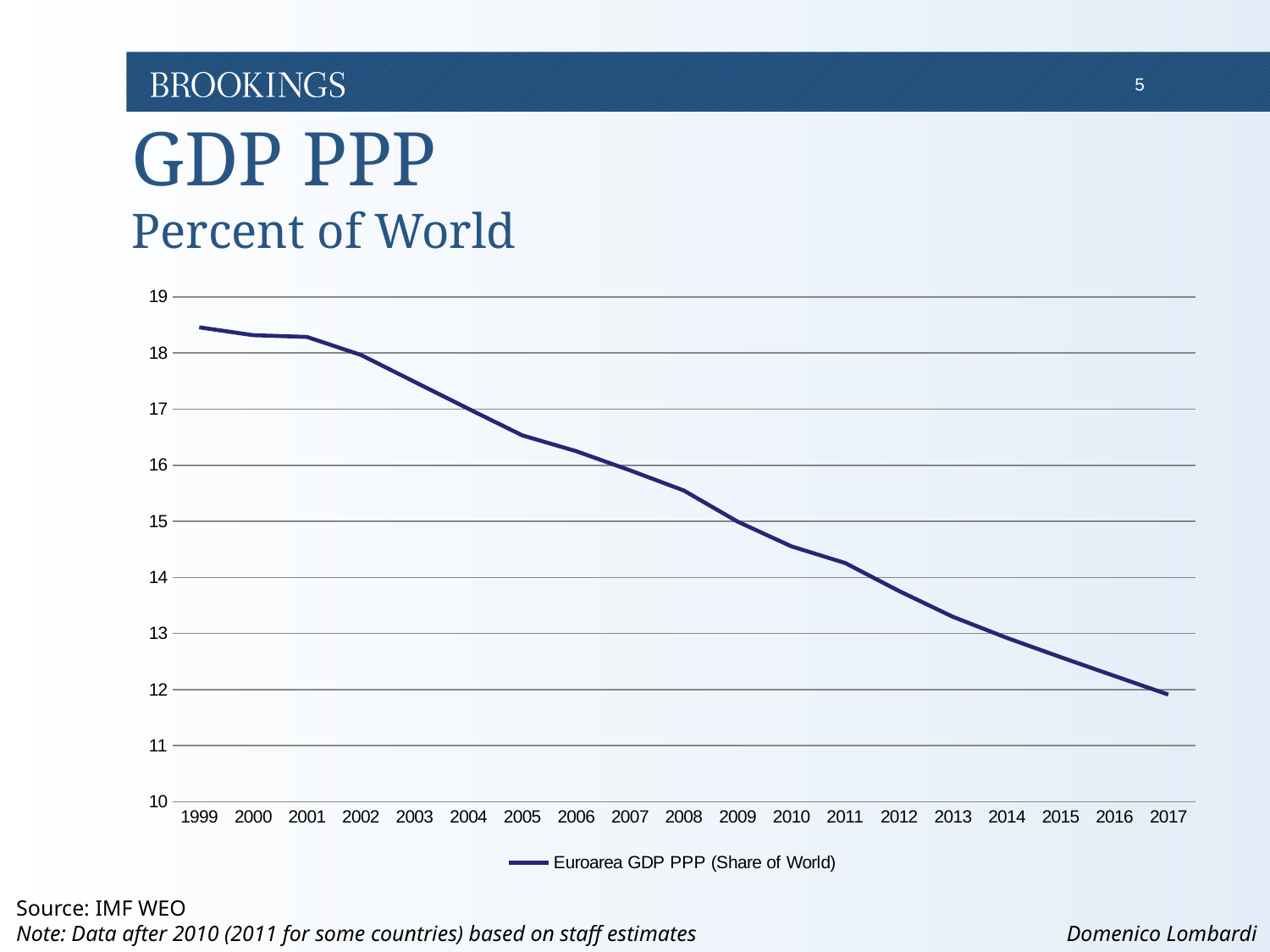
What is the name of the series shown in the legend? Euroarea GDP PPP (Share of World) What kind of chart is shown on the slide? line chart How many series does the legend list? 1 How many years are plotted along the x axis? 19 In which year is the Euroarea GDP PPP share of world lowest? 2017 Which year has the larger Euroarea GDP PPP share of world, 2003 or 2012? 2003 Is the value for 2017 greater or less than 13? less Is the value for 1999 greater or less than 18? greater In which year is the Euroarea GDP PPP share of world highest? 1999 Is the value for 2005 greater or less than 16? greater Does the Euroarea GDP PPP share of world rise or fall from 1999 to 2017? fall